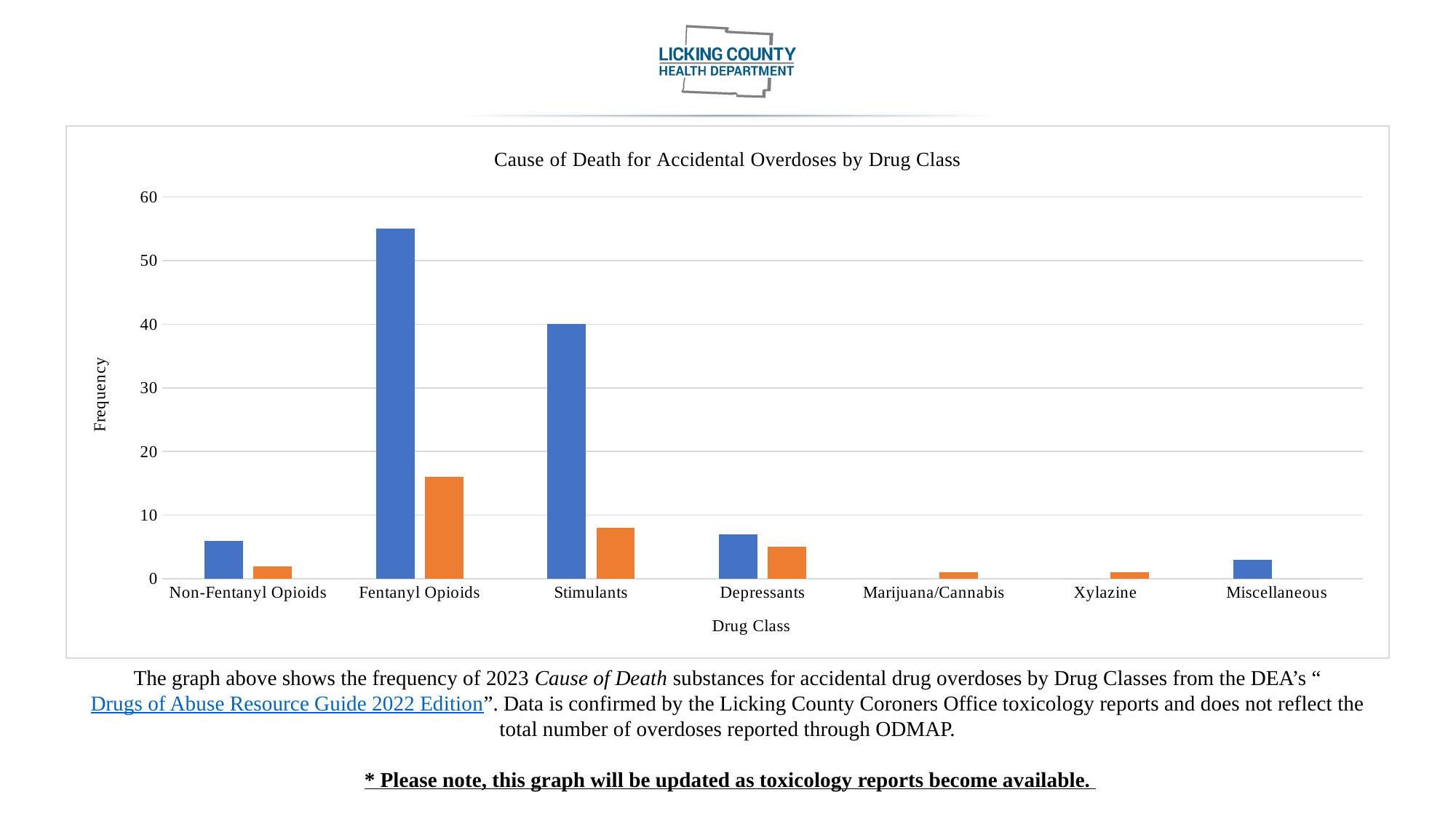
Is the blue bar for Fentanyl Opioids greater or less than 50? greater Which drug class has the highest orange bar? Fentanyl Opioids Is the blue bar for Depressants greater or less than 10? less Which is larger, the blue bar for Fentanyl Opioids or the blue bar for Stimulants? Fentanyl Opioids Which drug class has the highest blue bar? Fentanyl Opioids Is the orange bar for Stimulants greater or less than 10? less Which is larger, the blue bar for Non-Fentanyl Opioids or the orange bar for Non-Fentanyl Opioids? the blue bar How many drug class categories are shown on the x axis? 7 What kind of chart is shown on the slide? bar chart What is the title of the chart? Cause of Death for Accidental Overdoses by Drug Class What is the label on the y axis of the chart? Frequency